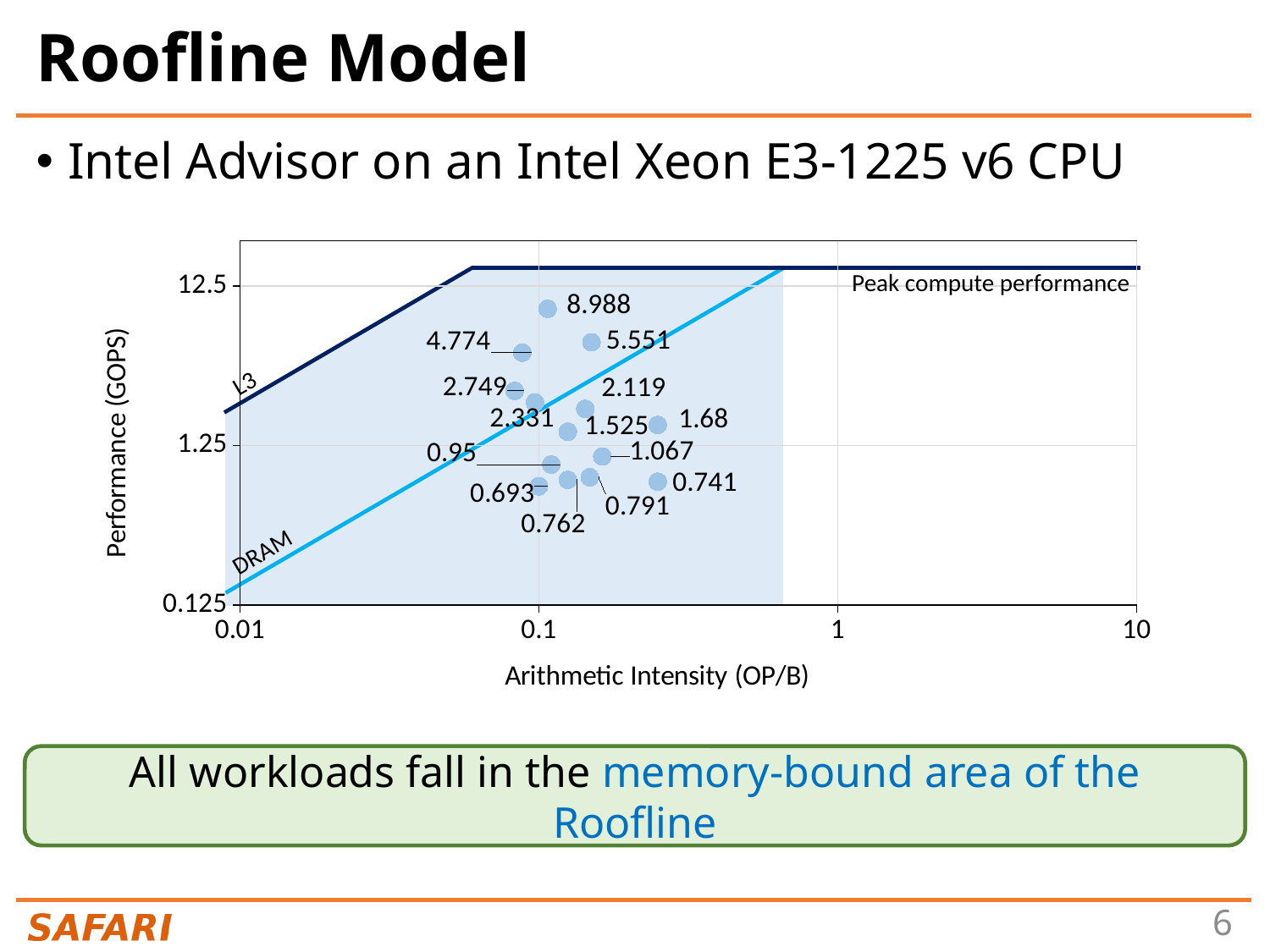
Which labeled value is larger, 2.331 or 2.119? 2.331 Which labeled value is larger, 5.551 or 4.774? 5.551 How many workload data points are labeled with values on the chart? 14 What is the highest performance value labeled among the plotted workload points? 8.988 Is the point labeled 0.741 greater or less than 1.25 on the y axis? less What is the label of the x axis of the chart? Arithmetic Intensity (OP/B) What are the names of the two sloped roofline lines drawn on the chart? L3 and DRAM What is the difference between the highest labeled value (8.988) and the lowest labeled value (0.693)? 8.295 Is the highest plotted workload point (8.988) greater or less than 12.5 on the y axis? less What is the difference between the labeled values 1.68 and 1.525? 0.155 What is the lowest performance value labeled among the plotted workload points? 0.693 What kind of chart is shown on the slide? scatter chart